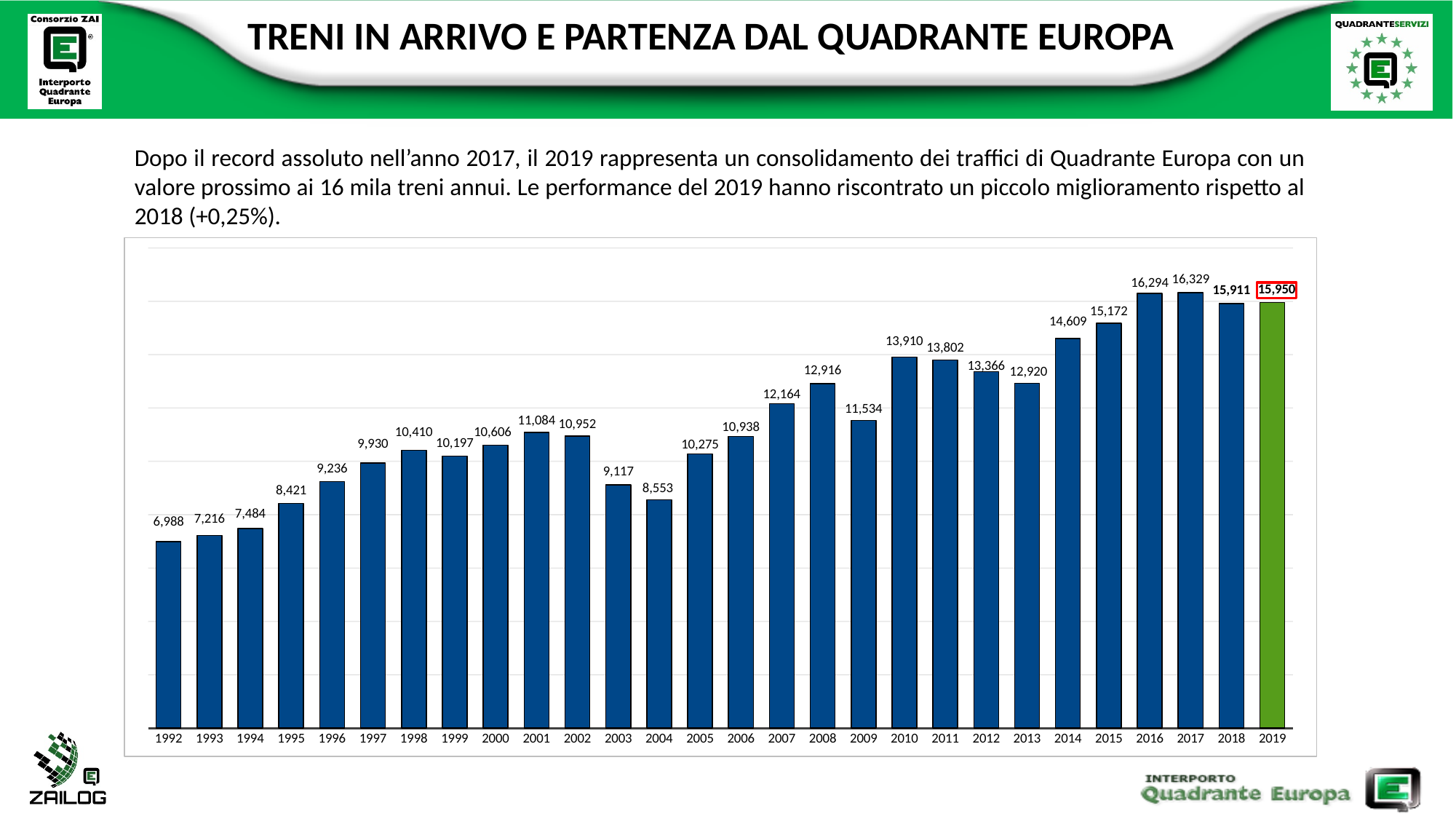
What is the difference between the values for 2019 and 2018? 39 Which bar is coloured green instead of blue? 2019 How many years are shown on the x axis? 28 What is the difference between the values for 2010 and 2009? 2,376 Which year has the highest value? 2017 What kind of chart is shown on the slide? Bar chart What is the value for 2019? 15,950 Which is larger, the value for 2012 or the value for 2013? 2012 Which is larger, the value for 2004 or the value for 2005? 2005 What is the value for 2003? 9,117 What is the value for 2010? 13,910 Which year has the lowest value? 1992